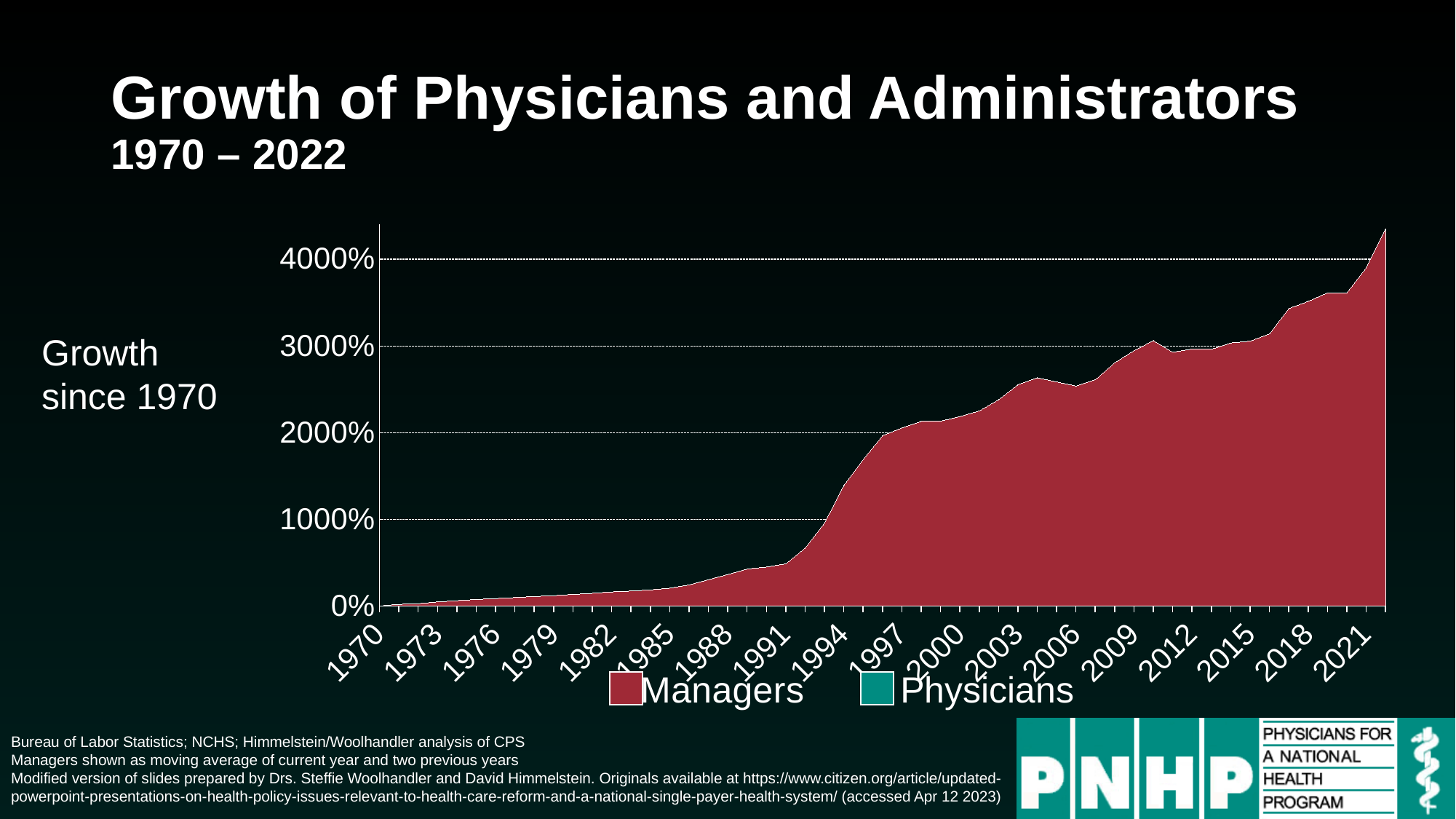
Is the value for Managers in 2006 greater or less than 2000%? greater How many year labels are shown on the x axis? 18 Which series shows the larger growth since 1970, Managers or Physicians? Managers What is the title of the chart on the slide? Growth of Physicians and Administrators 1970 – 2022 Is the value for Managers in 2021 greater or less than 3000%? greater Does the Managers series generally rise or fall from 1970 to 2021? Rise Is the value for Managers in 1991 greater or less than 1000%? less How many series does the legend list? 2 What are the two series named in the legend? Managers and Physicians What kind of chart is shown on the slide? Area chart